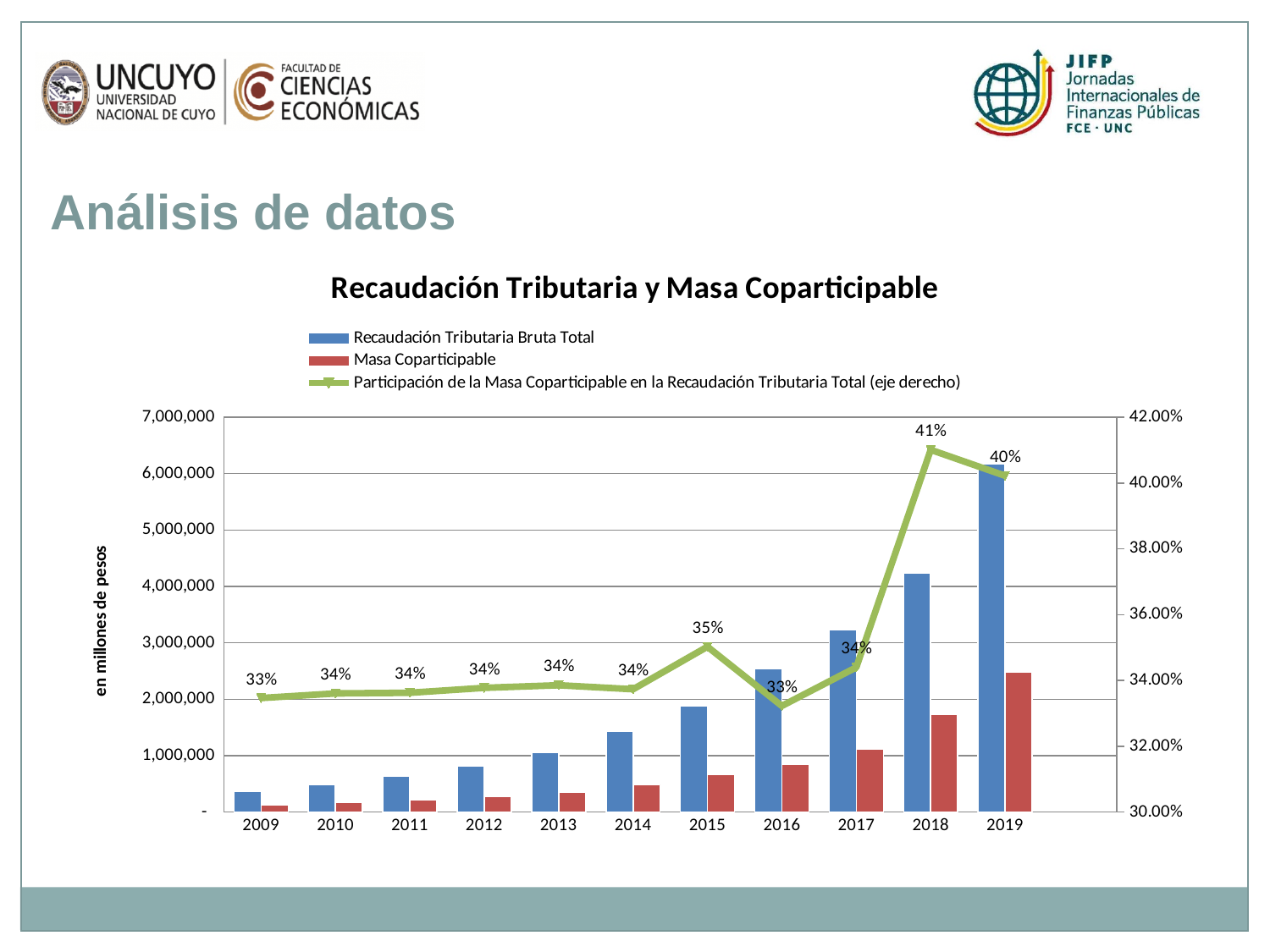
Is the Recaudación Tributaria Bruta Total value for 2015 greater or less than 2,000,000? less What is the value of the Participación de la Masa Coparticipable line for 2009? 33% How many series does the legend list? 3 Is the Recaudación Tributaria Bruta Total value for 2019 greater or less than 6,000,000? greater What is the value of the Participación de la Masa Coparticipable line for 2018? 41% Which year has the larger Recaudación Tributaria Bruta Total bar, 2018 or 2019? 2019 What is the value of the Participación de la Masa Coparticipable line for 2015? 35% Do the Recaudación Tributaria Bruta Total bars rise or fall from 2009 to 2019? rise What is the difference between the Participación values for 2018 and 2015? 6% What is the difference between the Participación values for 2018 and 2019? 1% How many years are shown on the x axis of the chart? 11 In which year does the Participación de la Masa Coparticipable line reach its highest value? 2018